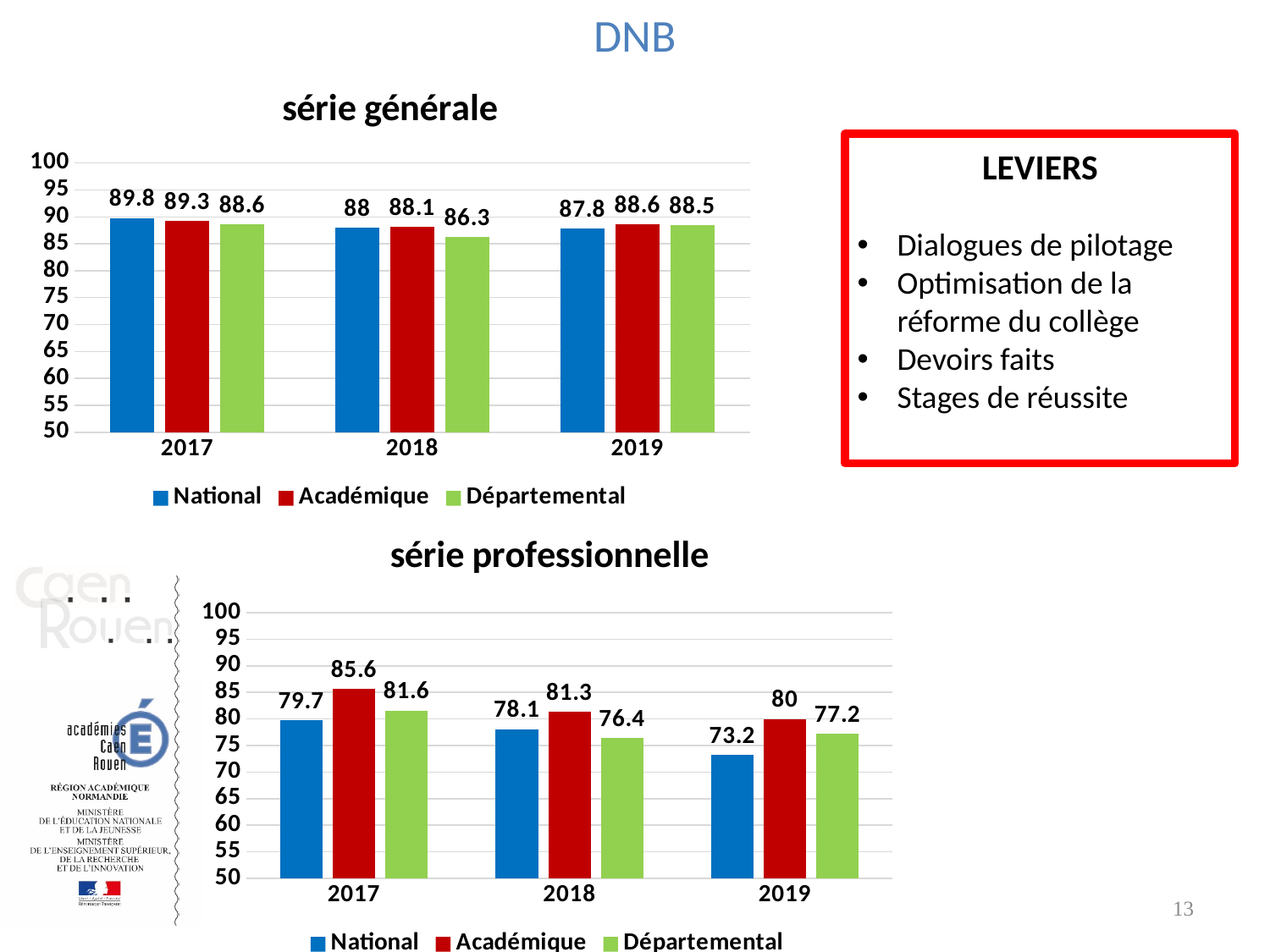
How many years are shown on the x axis of the 'série professionnelle' chart? 3 In the 'série professionnelle' chart, what is the difference between the Académique and National values in 2019? 6.8 In the 'série professionnelle' chart, what is the value for Académique in 2017? 85.6 What kind of chart is the 'série professionnelle' chart? Bar chart How many series does the legend of the 'série générale' chart list? 3 In the 'série professionnelle' chart, which is larger in 2017: Départemental or National? Départemental In the 'série professionnelle' chart, what is the value for National in 2019? 73.2 In the 'série générale' chart, what is the value for Départemental in 2018? 86.3 In the 'série générale' chart, what is the value for National in 2017? 89.8 In the 'série professionnelle' chart, which series has the highest value in 2018? Académique In the 'série générale' chart, what is the difference between the Académique and Départemental values in 2018? 1.8 In the 'série professionnelle' chart, which year has the lowest National value? 2019